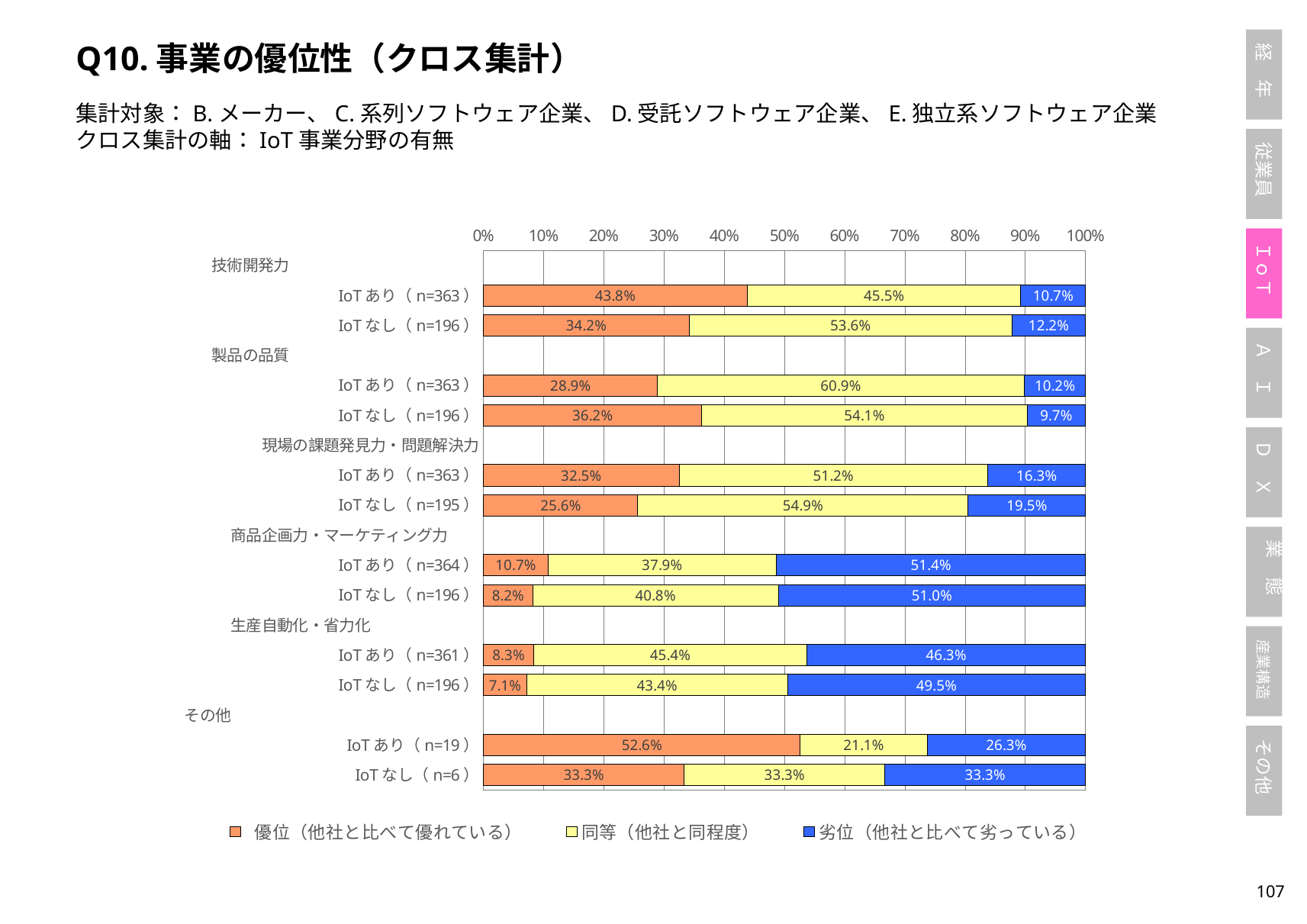
What type of chart is shown on the slide? Stacked bar chart What is the 優位 value for その他, IoT あり (n=19)? 52.6% How many series does the legend list? 3 Which bar has the highest 同等 value? 製品の品質, IoT あり (n=363) What is the label of the blue series in the legend? 劣位（他社と比べて劣っている） What is the 劣位 value for 商品企画力・マーケティング力, IoT あり (n=364)? 51.4% What is the difference between the 優位 values for 技術開発力 IoT あり (n=363) and IoT なし (n=196)? 9.6% Which bar has the lowest 優位 value? 生産自動化・省力化, IoT なし (n=196) Which is larger: the 劣位 value for 生産自動化・省力化 IoT あり (n=361) or IoT なし (n=196)? IoT なし (n=196) What is the 同等 value for 製品の品質, IoT あり (n=363)? 60.9% What is the 劣位 value for 現場の課題発見力・問題解決力, IoT なし (n=195)? 19.5% What is the 優位 value for 技術開発力, IoT あり (n=363)? 43.8%